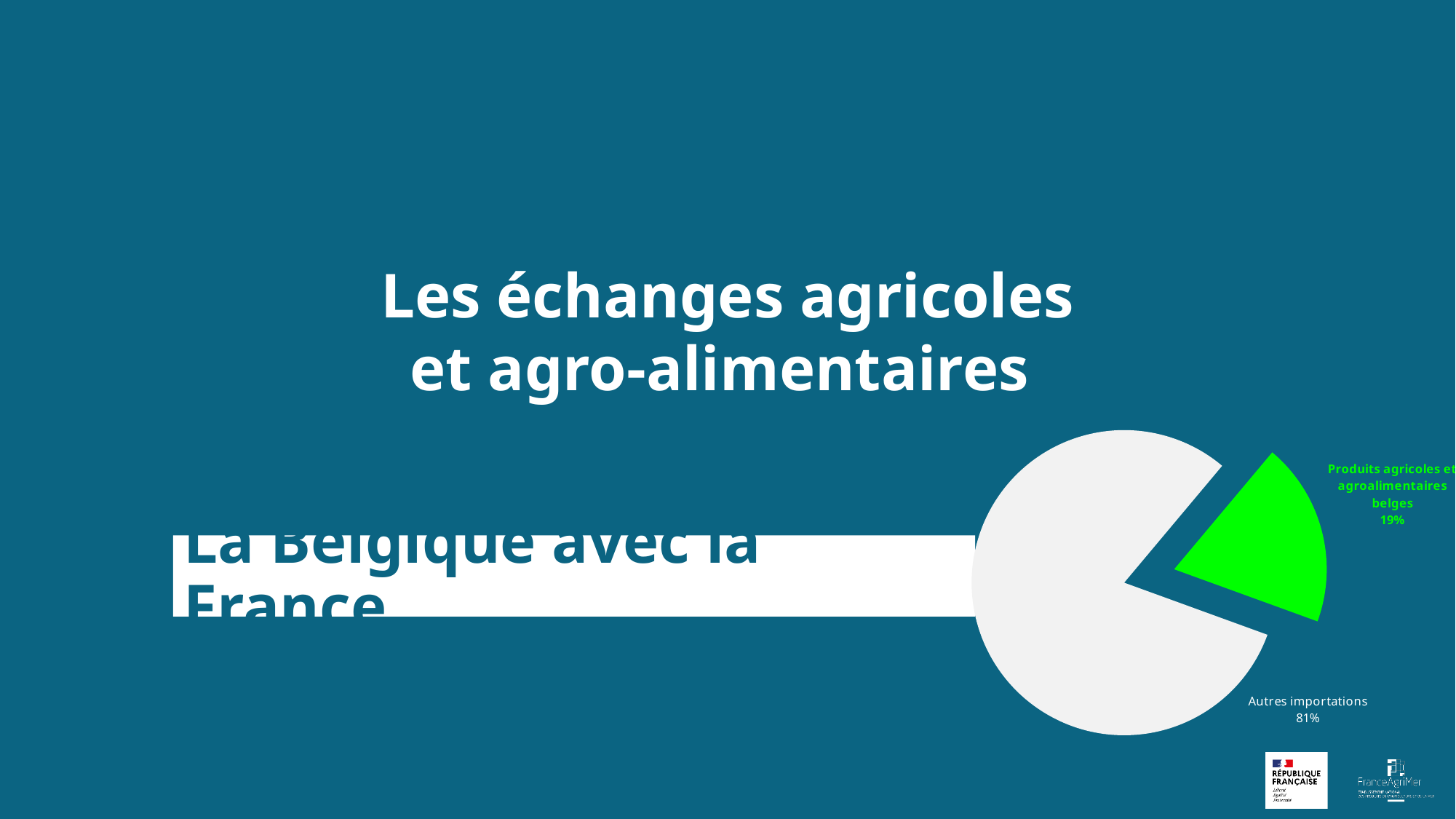
What kind of chart is shown on the slide? pie chart What share of the pie is labelled "Autres importations"? 81% What colour is the "Produits agricoles et agroalimentaires belges" slice? green What is the difference in percentage points between the "Autres importations" slice and the "Produits agricoles et agroalimentaires belges" slice? 62 What is the total of the two percentages shown on the pie chart? 100% Which is larger: the "Autres importations" slice or the "Produits agricoles et agroalimentaires belges" slice? Autres importations Which slice of the pie chart is the largest? Autres importations What share of the pie is labelled "Produits agricoles et agroalimentaires belges"? 19% How many slices does the pie chart have? 2 Which slice of the pie chart is the smallest? Produits agricoles et agroalimentaires belges